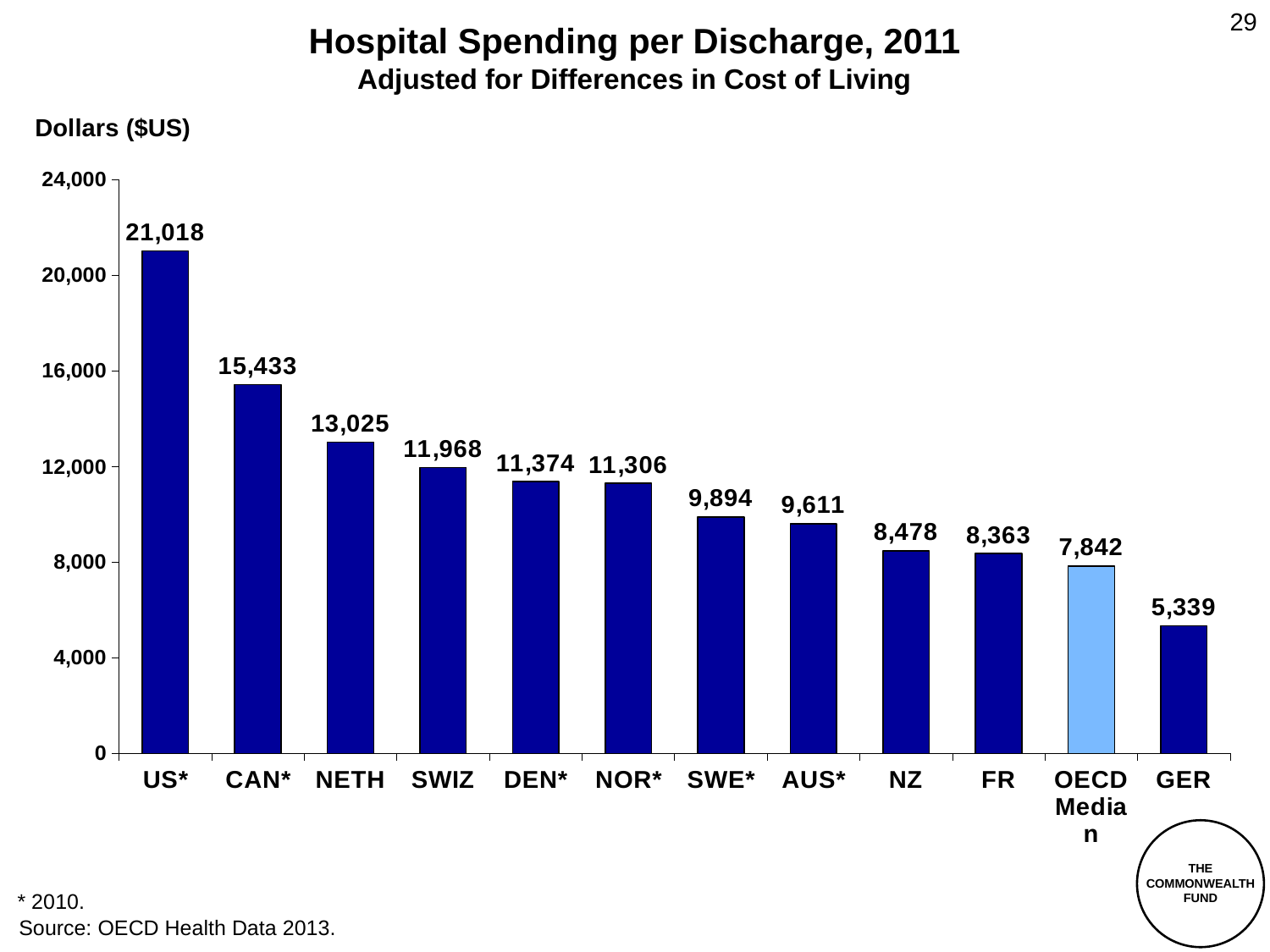
Which bar is shown in a lighter blue colour than the others? OECD Median What is the value shown for the OECD Median? 7,842 What is the difference between the values for NZ and FR? 115 Which is larger, the value for SWE* or the value for AUS*? SWE* Which category has the lowest hospital spending per discharge? GER What is the difference between the values for US* and CAN*? 5,585 Which category has the highest hospital spending per discharge? US* What kind of chart is shown on the slide? bar chart What is the value shown for NETH? 13,025 What is the hospital spending per discharge for US*? 21,018 How many bars are shown in the chart? 12 Is the value for SWIZ greater or less than 12,000? less